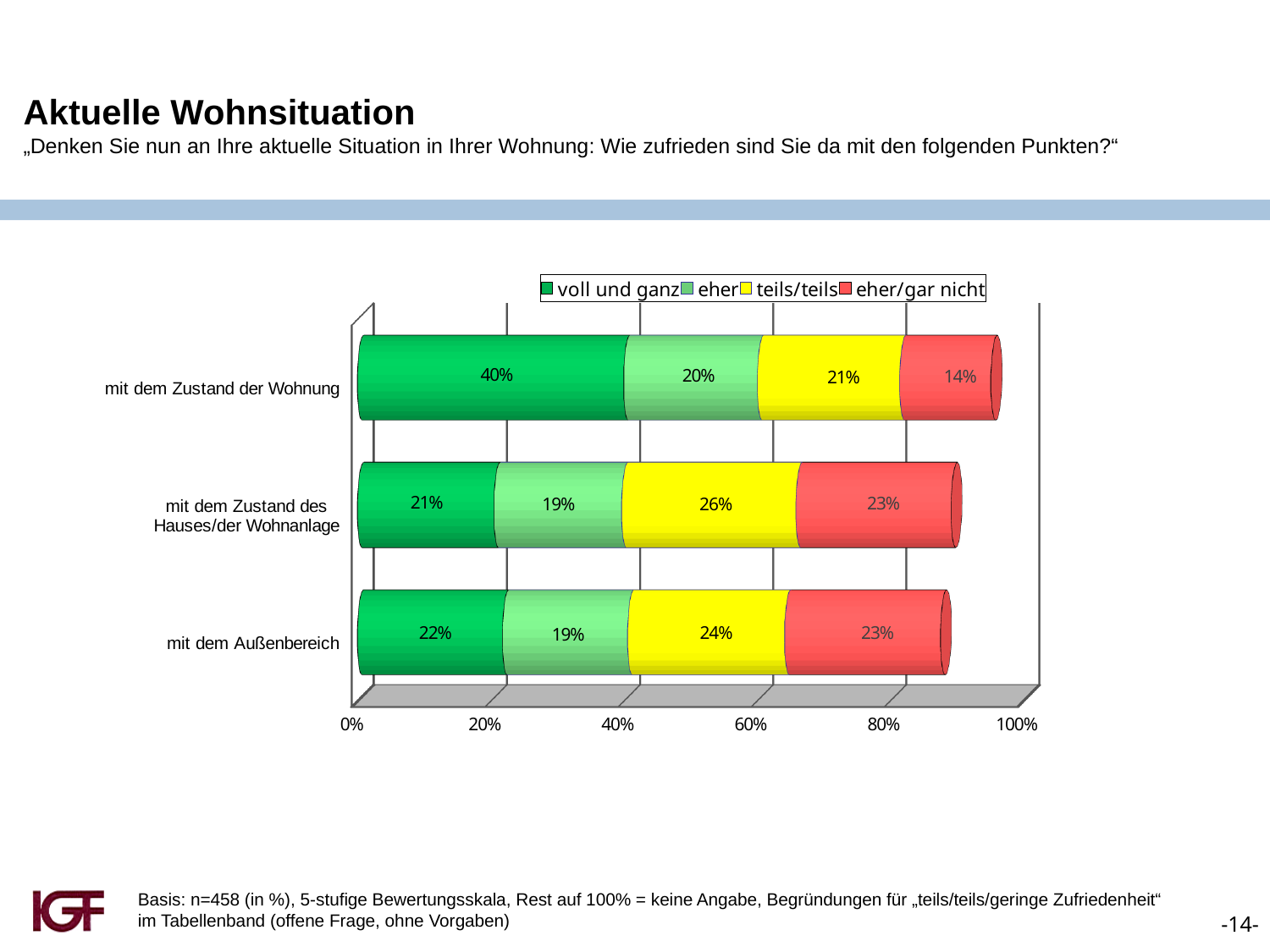
How many series does the legend list? 4 Which is larger: the "teils/teils" value for "mit dem Zustand des Hauses/der Wohnanlage" or for "mit dem Außenbereich"? mit dem Zustand des Hauses/der Wohnanlage Which category has the highest "voll und ganz" value? mit dem Zustand der Wohnung What is the "teils/teils" value for "mit dem Außenbereich"? 24% Which colour represents the "eher/gar nicht" series in the legend? Red Which category has the lowest "eher/gar nicht" value? mit dem Zustand der Wohnung What kind of chart is shown on the slide? Stacked bar chart How many categories are shown on the chart? 3 What is the "eher/gar nicht" value for "mit dem Zustand des Hauses/der Wohnanlage"? 23% What is the total of the stacked bar for "mit dem Zustand der Wohnung"? 95% What is the difference between the "voll und ganz" values for "mit dem Zustand der Wohnung" and "mit dem Außenbereich"? 18 percentage points What percentage of respondents are "voll und ganz" satisfied with "mit dem Zustand der Wohnung"? 40%